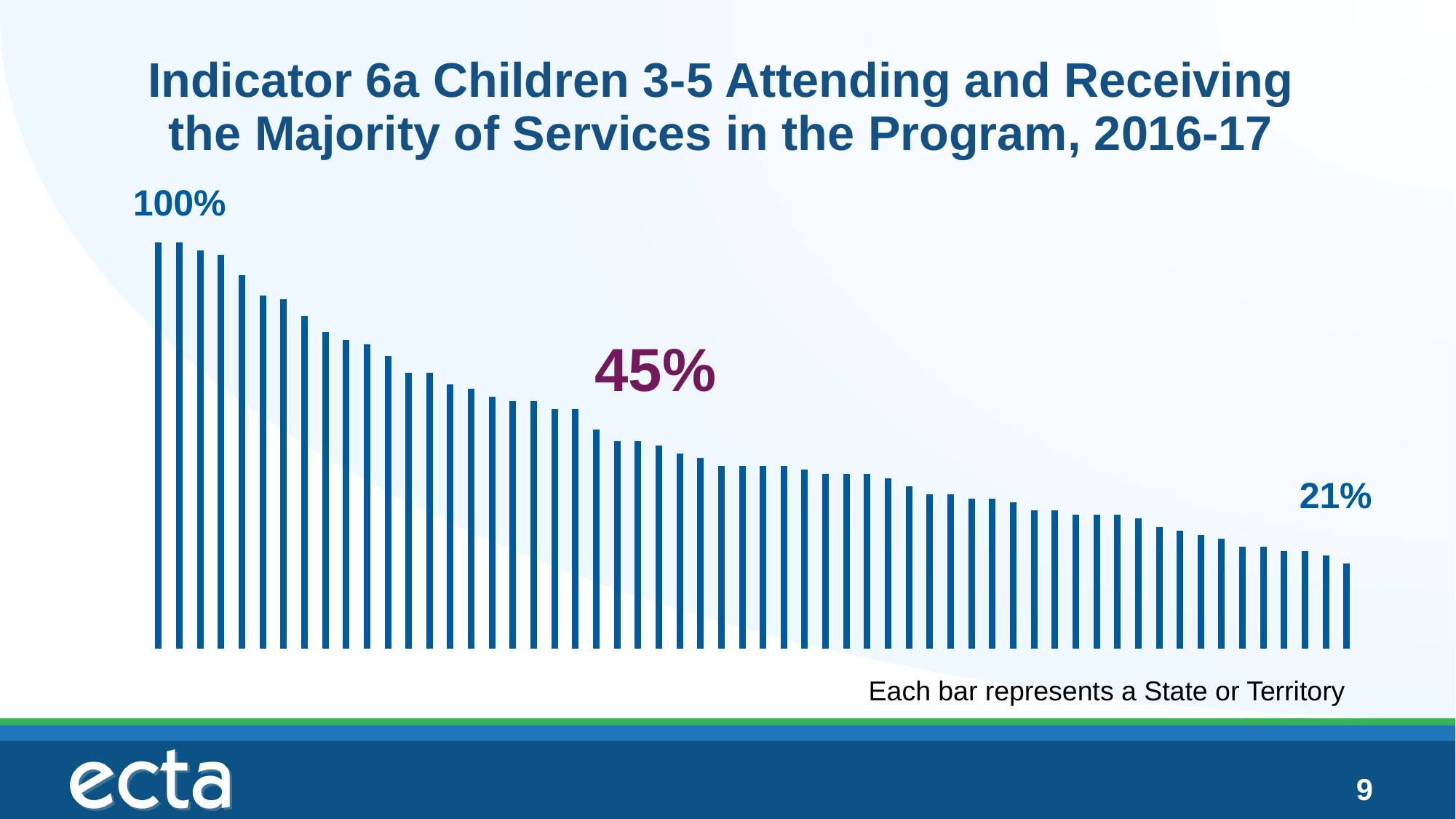
What kind of chart is shown on the slide? Bar chart What is the value of the lowest bar in the chart? 21% What is the title of the chart? Indicator 6a Children 3-5 Attending and Receiving the Majority of Services in the Program, 2016-17 Do the bar values rise or fall from left to right across the chart? Fall Which is larger, the value labelled at the left end of the chart or the value labelled at the right end? The left end (100%) What is the difference between the highest bar value (100%) and the lowest bar value (21%)? 79 percentage points What is the value of the highest bar in the chart? 100% According to the note on the slide, what does each bar represent? A State or Territory What large value is printed in purple in the middle of the chart? 45%